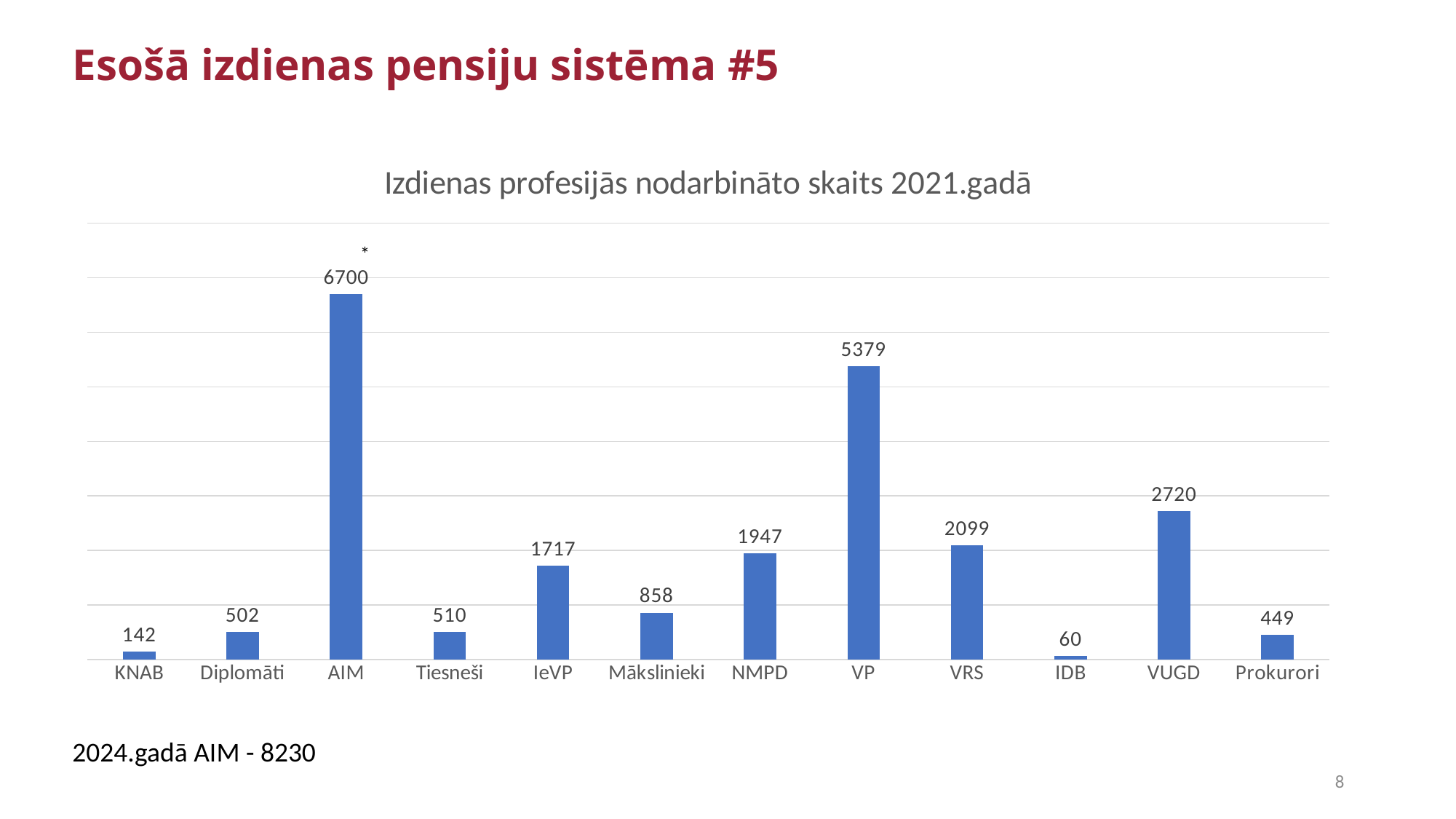
What is the title of the chart? Izdienas profesijās nodarbināto skaits 2021.gadā What is the difference between the values for AIM and VP? 1321 Which category has the highest value? AIM What kind of chart is this? bar chart What is the difference between the values for Tiesneši and Diplomāti? 8 What is the value for IDB? 60 What is the value for VP? 5379 How many categories are shown on the x axis? 12 Which category has the lowest value? IDB What is the value for VUGD? 2720 What is the value for AIM? 6700 Which is larger, the value for VRS or the value for NMPD? VRS